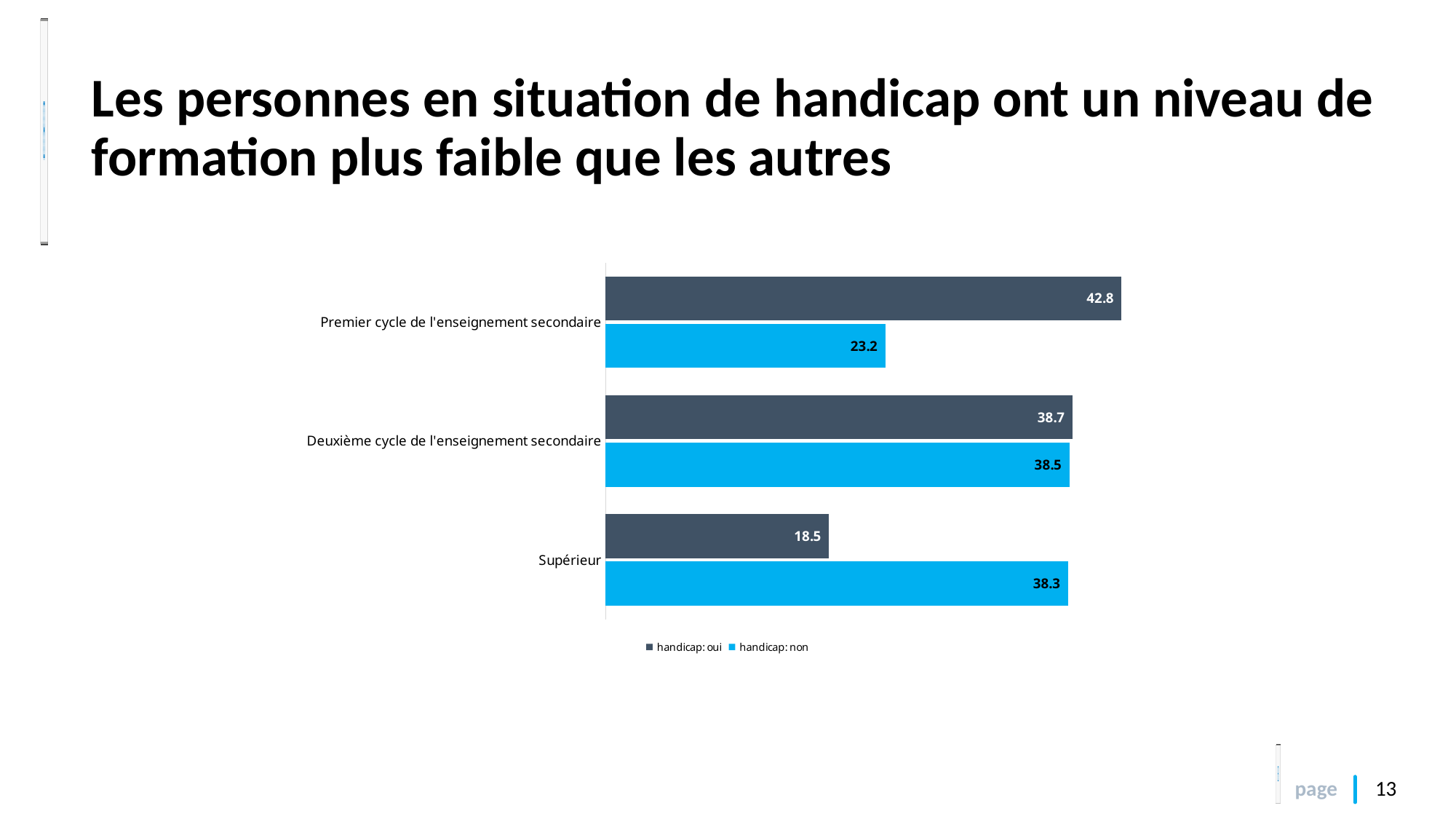
For 'Supérieur', which series has the larger value, 'handicap: oui' or 'handicap: non'? handicap: non What is the difference between the 'handicap: oui' and 'handicap: non' values for 'Premier cycle de l'enseignement secondaire'? 19.6 What is the value for 'handicap: non' in the 'Deuxième cycle de l'enseignement secondaire' category? 38.5 How many series does the legend list? 2 What is the difference between the 'handicap: non' and 'handicap: oui' values for 'Supérieur'? 19.8 Which category has the highest value for the 'handicap: oui' series? Premier cycle de l'enseignement secondaire What is the value for 'handicap: non' in the 'Supérieur' category? 38.3 How many categories are shown on the chart? 3 Which category has the lowest value for the 'handicap: oui' series? Supérieur Which category has the lowest value for the 'handicap: non' series? Premier cycle de l'enseignement secondaire What kind of chart is shown on the slide? Bar chart What is the value for 'handicap: oui' in the 'Premier cycle de l'enseignement secondaire' category? 42.8